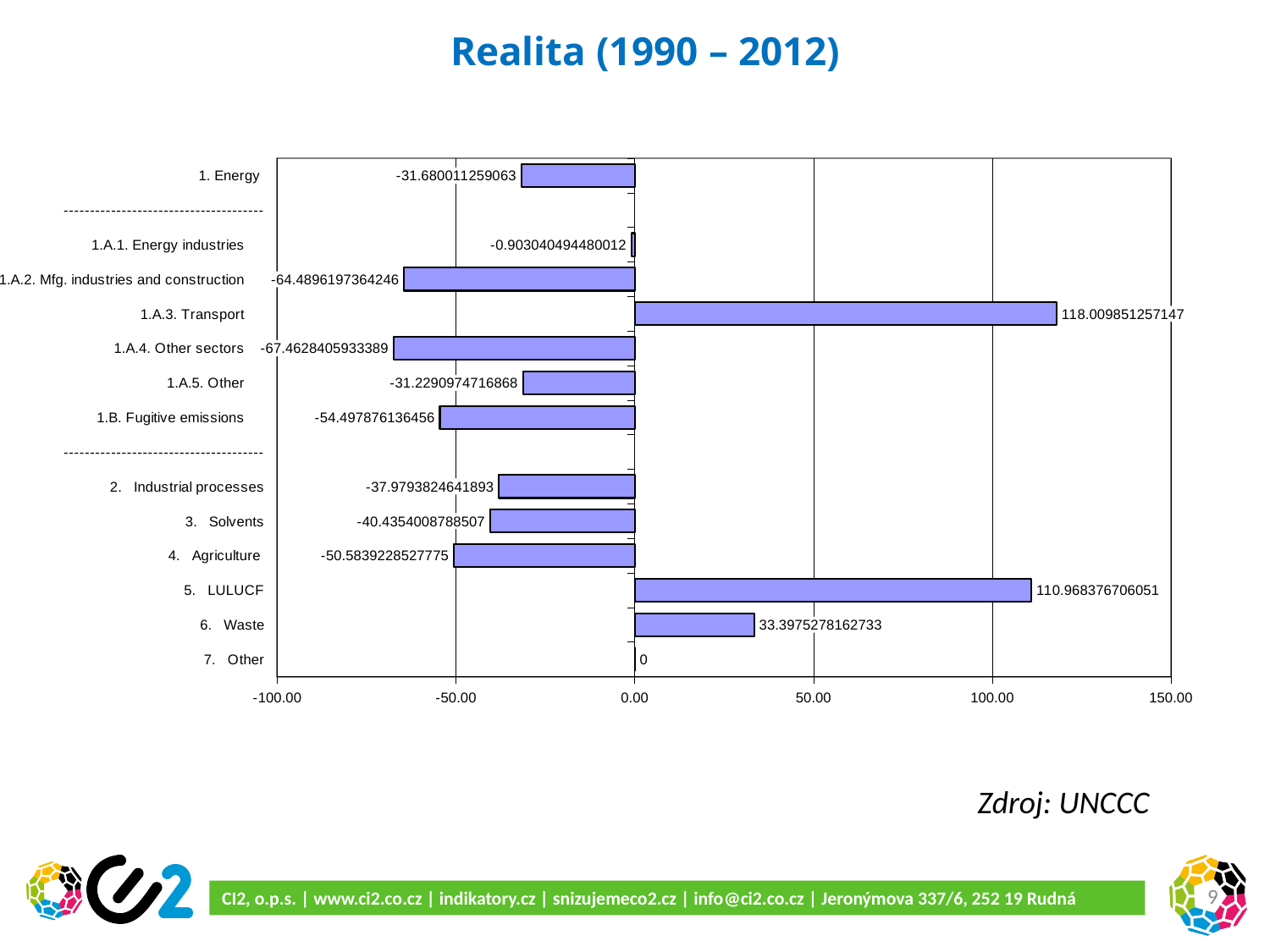
Is the value for 6. Waste greater or less than 50.00? less What is the value for 1.A.3. Transport? 118.009851257147 What is the title of the slide? Realita (1990 – 2012) What is the value for 6. Waste? 33.3975278162733 Which is larger, the value for 1.A.3. Transport or the value for 5. LULUCF? 1.A.3. Transport What kind of chart is shown on the slide? bar chart What is the value for 4. Agriculture? -50.5839228527775 What is the value for 5. LULUCF? 110.968376706051 What is the difference between the value for 6. Waste and the value for 7. Other? 33.3975278162733 What is the value for 1.A.1. Energy industries? -0.903040494480012 Which category has the highest value? 1.A.3. Transport Which category has the lowest value? 1.A.4. Other sectors